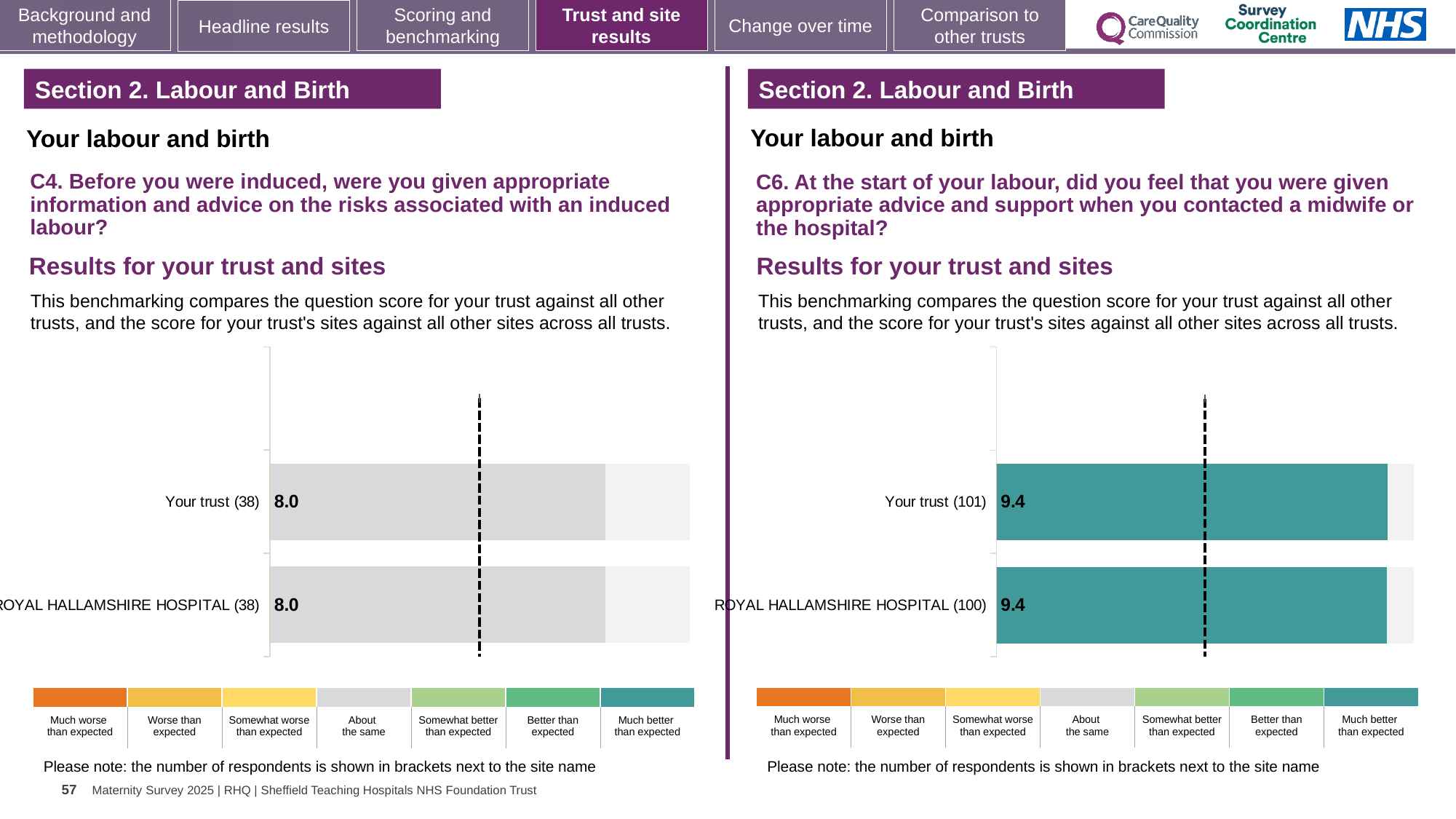
On the left chart (C4), how many respondents are shown in brackets for Your trust? 38 On the left chart (C4), which benchmark category does the colour of the bars correspond to according to the legend? About the same On the right chart (C6), what is the score for Royal Hallamshire Hospital? 9.4 On the right chart (C6), which benchmark category does the colour of the bars correspond to according to the legend? Much better than expected On the left chart (C4), what is the score for Your trust? 8.0 On the left chart (C4), what is the difference between the score for Your trust and the score for Royal Hallamshire Hospital? 0.0 What type of chart is used on the left (C4) to show the results for your trust and sites? Bar chart Is the score for Your trust on the right chart (C6) larger or smaller than the score for Your trust on the left chart (C4)? Larger On the left chart (C4), what is the score for Royal Hallamshire Hospital? 8.0 On the right chart (C6), how many bars are plotted? 2 On the right chart (C6), how many respondents are shown in brackets for Royal Hallamshire Hospital? 100 On the right chart (C6), what is the score for Your trust? 9.4